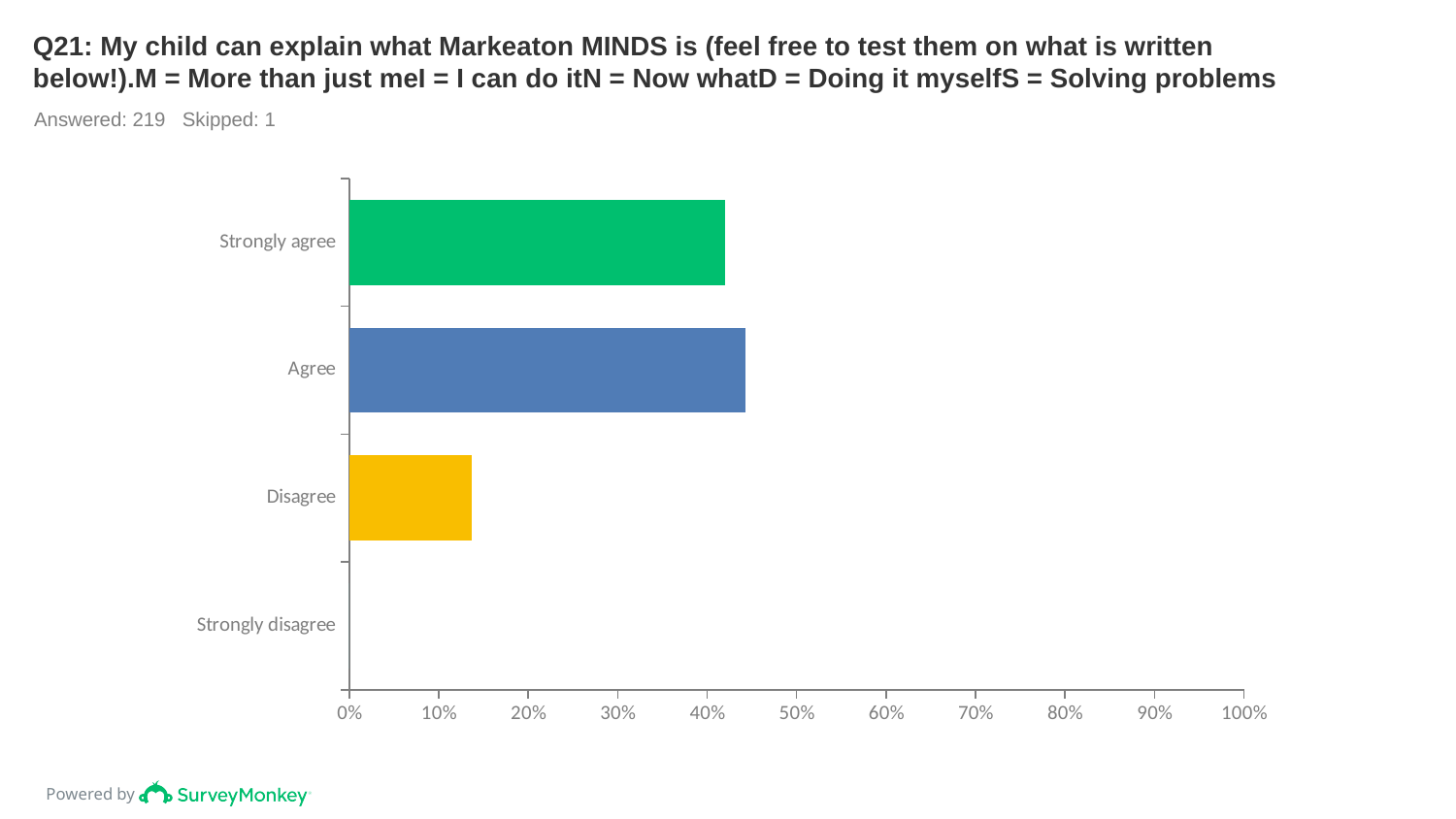
Is the value for Disagree greater or less than 10%? greater Which response category has the highest value? Agree Which is larger, the value for Disagree or the value for Strongly disagree? Disagree What kind of chart is shown on the slide? bar chart Which response category has the lowest value? Strongly disagree Is the value for Disagree greater or less than 20%? less What colour is the bar for Disagree? yellow Is the value for Agree greater or less than 40%? greater How many response categories are shown on the chart? 4 How many respondents answered this question according to the slide? 219 Which is larger, the value for Strongly agree or the value for Disagree? Strongly agree